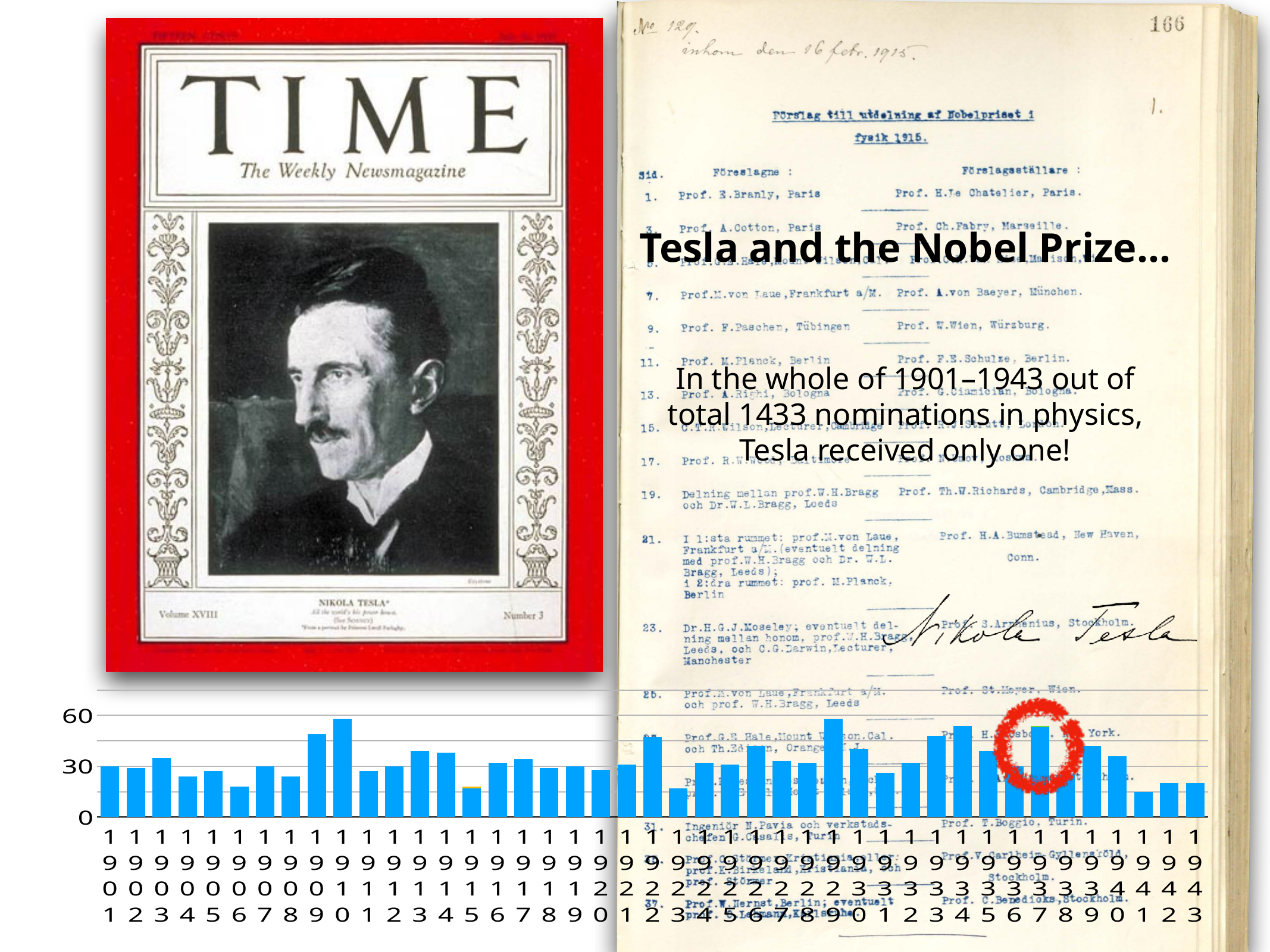
Which has the larger value, 1910 or 1906? 1910 Is the value for 1923 greater or less than 30? less Is the value for 1910 greater or less than 30? greater How many years (bars) does the chart at the bottom of the slide cover? 43 What is the last year shown on the x axis of the chart? 1943 Which has the larger value, 1909 or 1915? 1909 Is the value for 1913 greater or less than 30? greater What kind of chart is shown at the bottom of the slide? bar chart What is the first year shown on the x axis of the chart? 1901